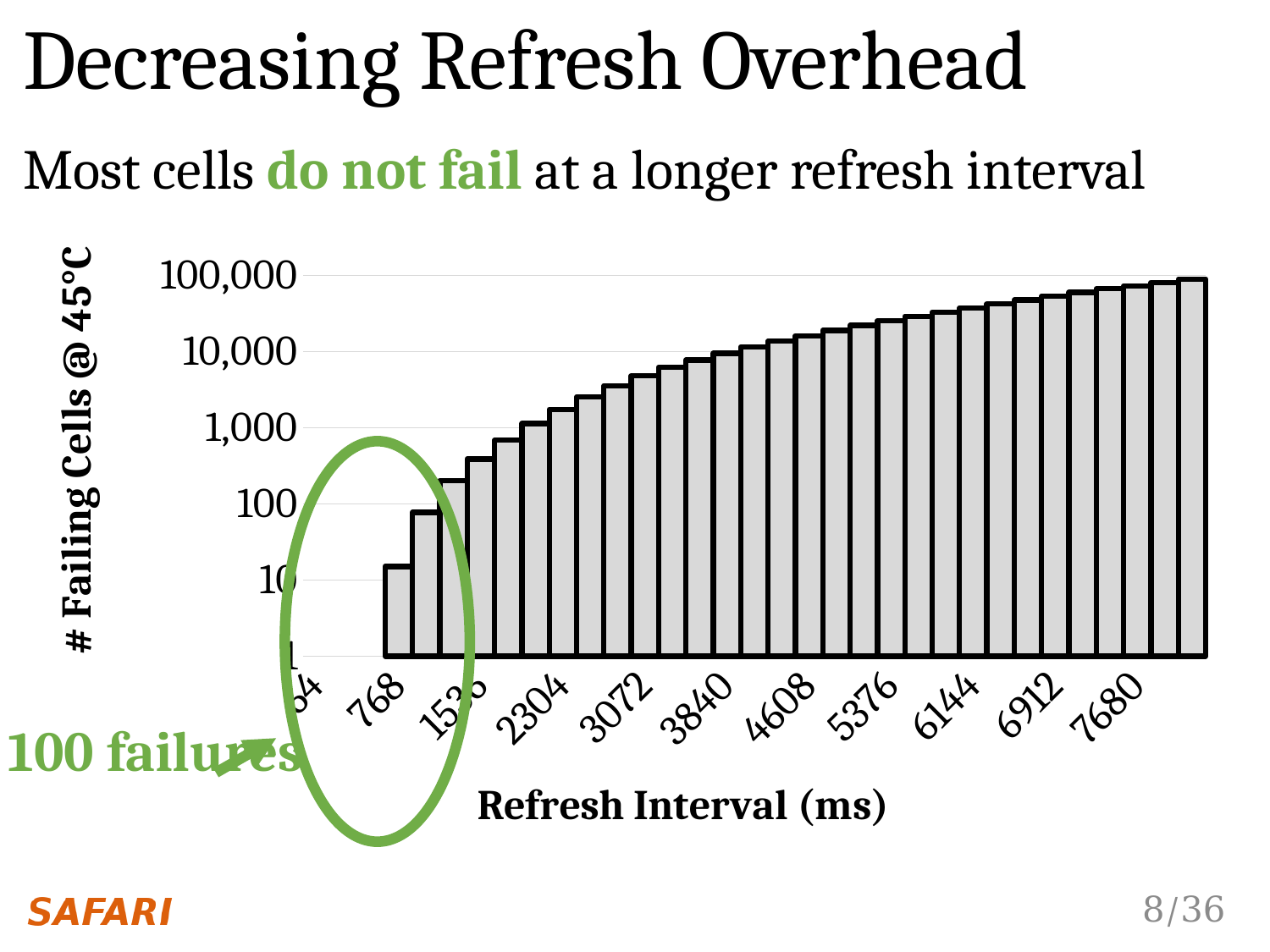
What is the title of the y-axis of the chart? # Failing Cells @ 45°C Is the number of failing cells at a refresh interval of 6144 ms greater or less than 10,000? greater Do the number of failing cells rise or fall as the refresh interval increases along the x axis? rise What is the title of the x-axis of the chart? Refresh Interval (ms) Is the number of failing cells at a refresh interval of 7680 ms greater or less than 100,000? less Which has more failing cells: a refresh interval of 2304 ms or 4608 ms? 4608 Is the number of failing cells at a refresh interval of 768 ms greater or less than 100? less What kind of chart is shown on the slide? bar chart